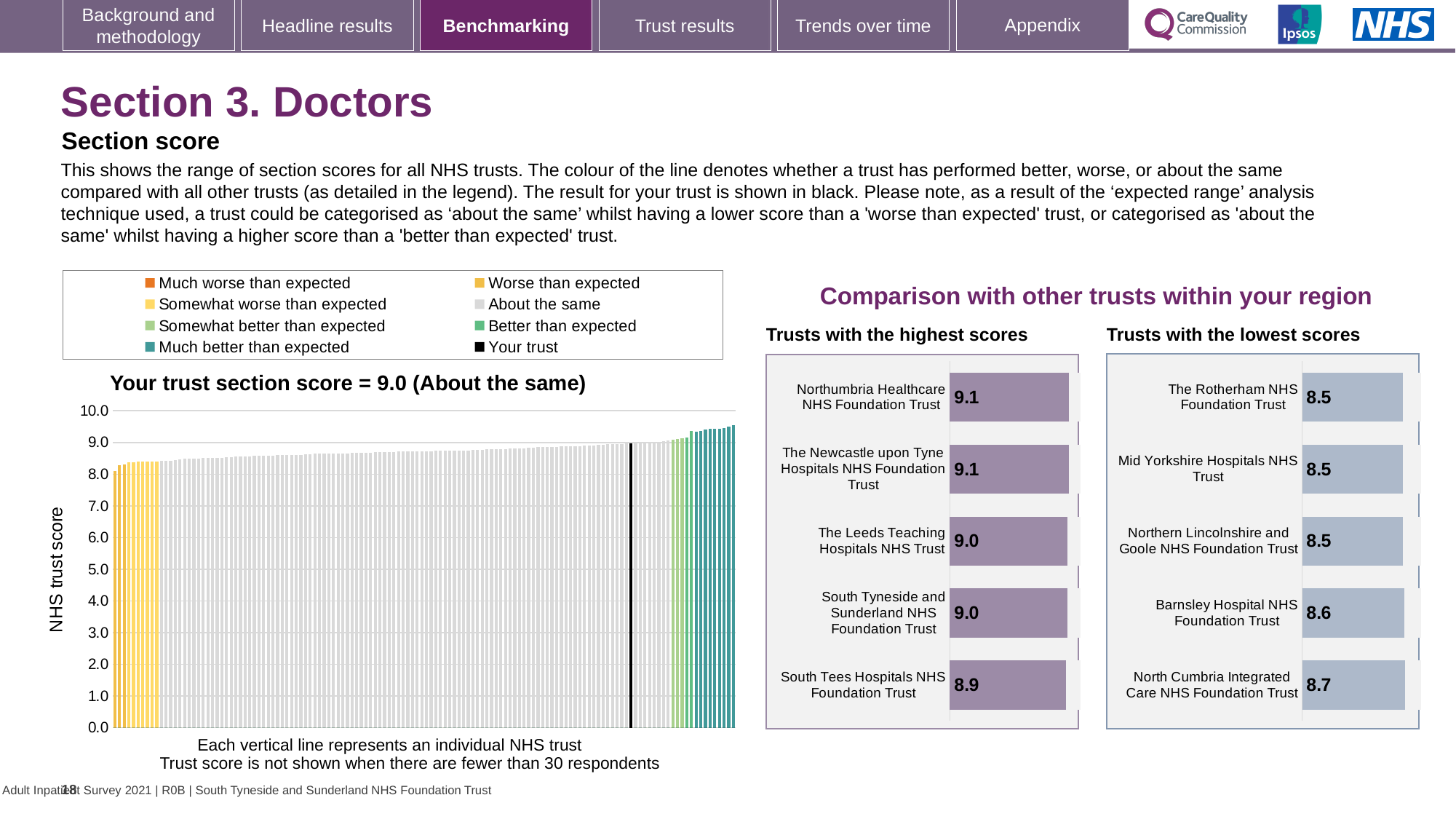
In the 'Trusts with the lowest scores' chart, what is the score for Barnsley Hospital NHS Foundation Trust? 8.6 In the 'Your trust section score' chart, do the trust scores rise or fall from left to right? rise In the 'Trusts with the lowest scores' chart, which trust has the highest score? North Cumbria Integrated Care NHS Foundation Trust In the 'Trusts with the highest scores' chart, what is the score for The Leeds Teaching Hospitals NHS Trust? 9.0 In the 'Trusts with the highest scores' chart, which trust has the lowest score? South Tees Hospitals NHS Foundation Trust In the 'Trusts with the lowest scores' chart, which has the larger score: Barnsley Hospital NHS Foundation Trust or North Cumbria Integrated Care NHS Foundation Trust? North Cumbria Integrated Care NHS Foundation Trust In the 'Trusts with the highest scores' chart, what is the difference between the scores of Northumbria Healthcare NHS Foundation Trust and South Tees Hospitals NHS Foundation Trust? 0.2 How many entries does the legend above the 'Your trust section score' chart list? 8 How many trusts are shown in the 'Trusts with the highest scores' chart? 5 What kind of chart is the 'Your trust section score' chart? bar chart In the 'Your trust section score' chart, what is the section score for your trust? 9.0 What is the y-axis label of the 'Your trust section score' chart? NHS trust score